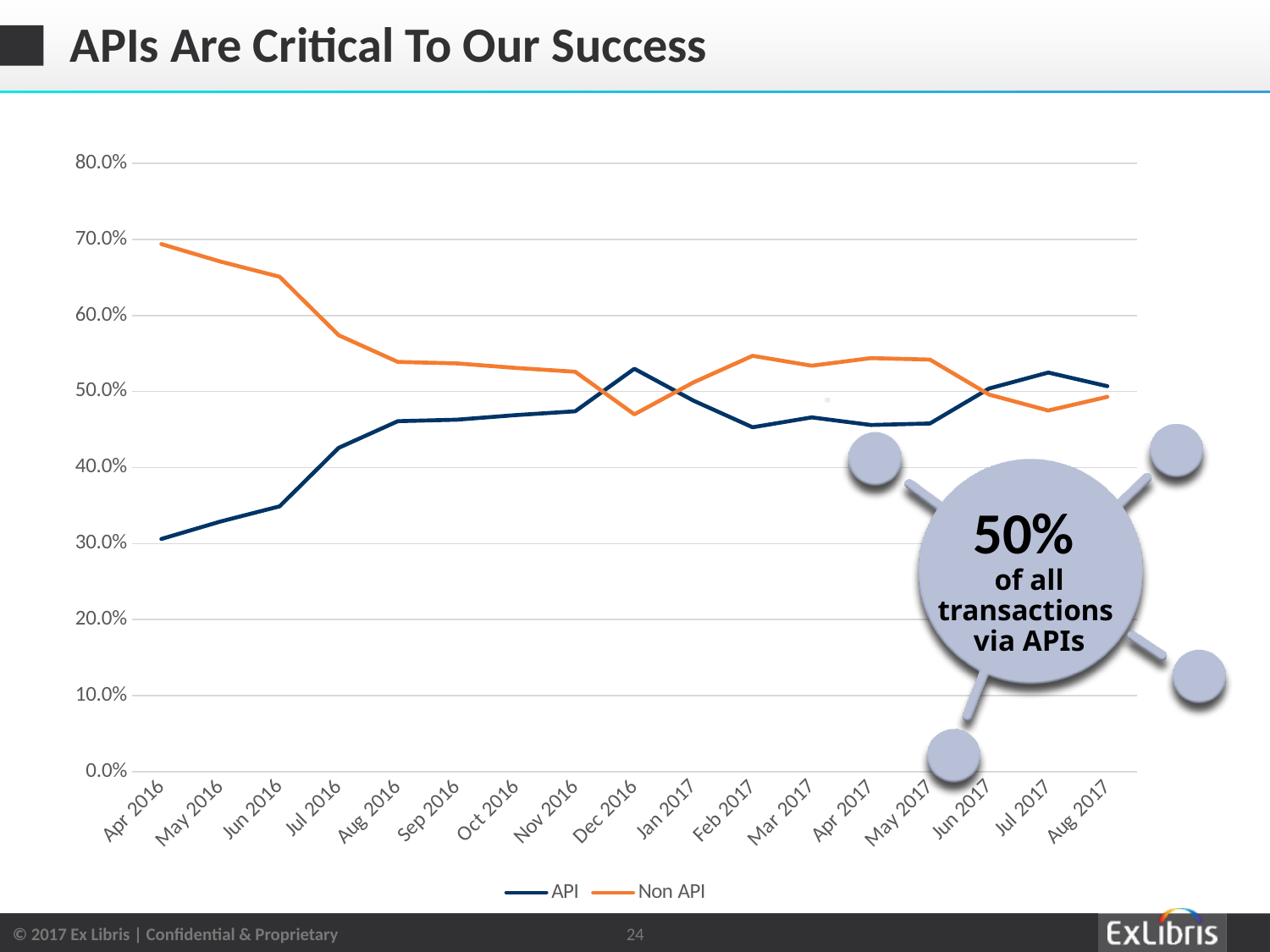
How many months are plotted along the x axis? 17 In Dec 2016, which series has the larger value, API or Non API? API Is the value for Non API in Jun 2016 greater or less than 60.0%? greater What kind of chart is shown on the slide? Line chart How many series does the legend list? 2 Does the API series generally rise or fall from Apr 2016 to Aug 2017? Rise In which month is the API series at its lowest? Apr 2016 Is the value for Non API in Apr 2016 greater or less than 60.0%? greater In which month is the Non API series at its highest? Apr 2016 In Apr 2016, which series has the larger value, API or Non API? Non API Is the value for API in Apr 2016 greater or less than 40.0%? less